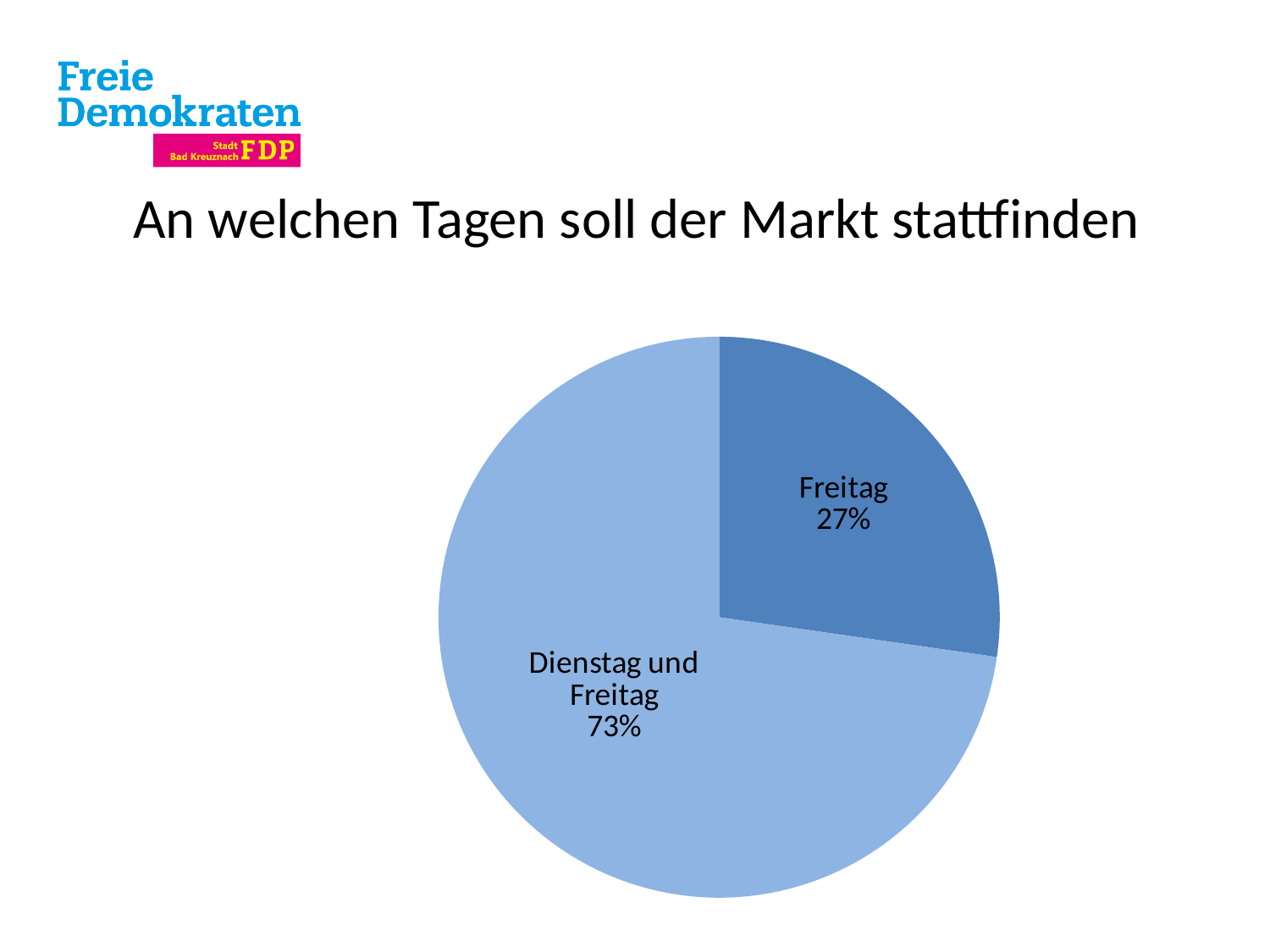
How many slices does the pie chart have? 2 Which slice is the smallest in the pie chart? Freitag Is the share for "Freitag" greater or less than 50%? less What share of the pie does the "Dienstag und Freitag" slice represent? 73% Which slice is the largest in the pie chart? Dienstag und Freitag What share of the pie does the "Freitag" slice represent? 27% Which slice is drawn in the darker blue colour? Freitag Is the share for "Dienstag und Freitag" greater or less than 50%? greater Which slice is larger, "Freitag" or "Dienstag und Freitag"? Dienstag und Freitag What is the title of the slide above the chart? An welchen Tagen soll der Markt stattfinden What kind of chart is shown on the slide? Pie chart What is the difference in percentage points between the "Dienstag und Freitag" slice and the "Freitag" slice? 46